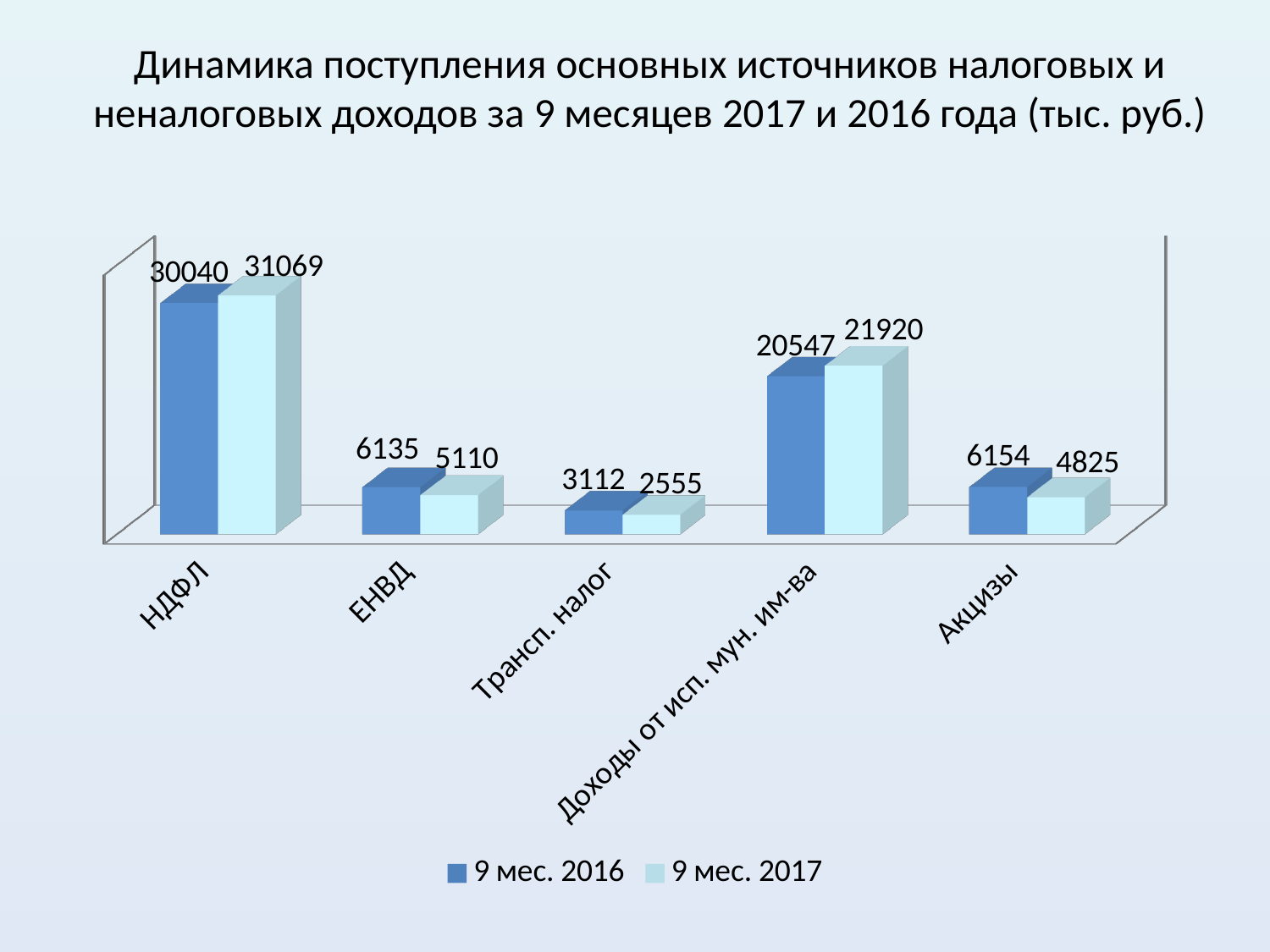
How many series does the legend list? 2 What is the value for ЕНВД in the 9 мес. 2016 series? 6135 What kind of chart is shown on the slide? Bar chart What is the value for Акцизы in the 9 мес. 2016 series? 6154 What is the value for НДФЛ in the 9 мес. 2017 series? 31069 Which series is shown in the darker blue colour? 9 мес. 2016 Which category has the lowest value in the 9 мес. 2016 series? Трансп. налог How many categories are shown on the x axis? 5 Which category has the highest value in the 9 мес. 2017 series? НДФЛ Which is larger for ЕНВД: the 9 мес. 2016 value or the 9 мес. 2017 value? 9 мес. 2016 What is the value for Трансп. налог in the 9 мес. 2017 series? 2555 What is the difference between the 9 мес. 2017 and 9 мес. 2016 values for Доходы от исп. мун. им-ва? 1373